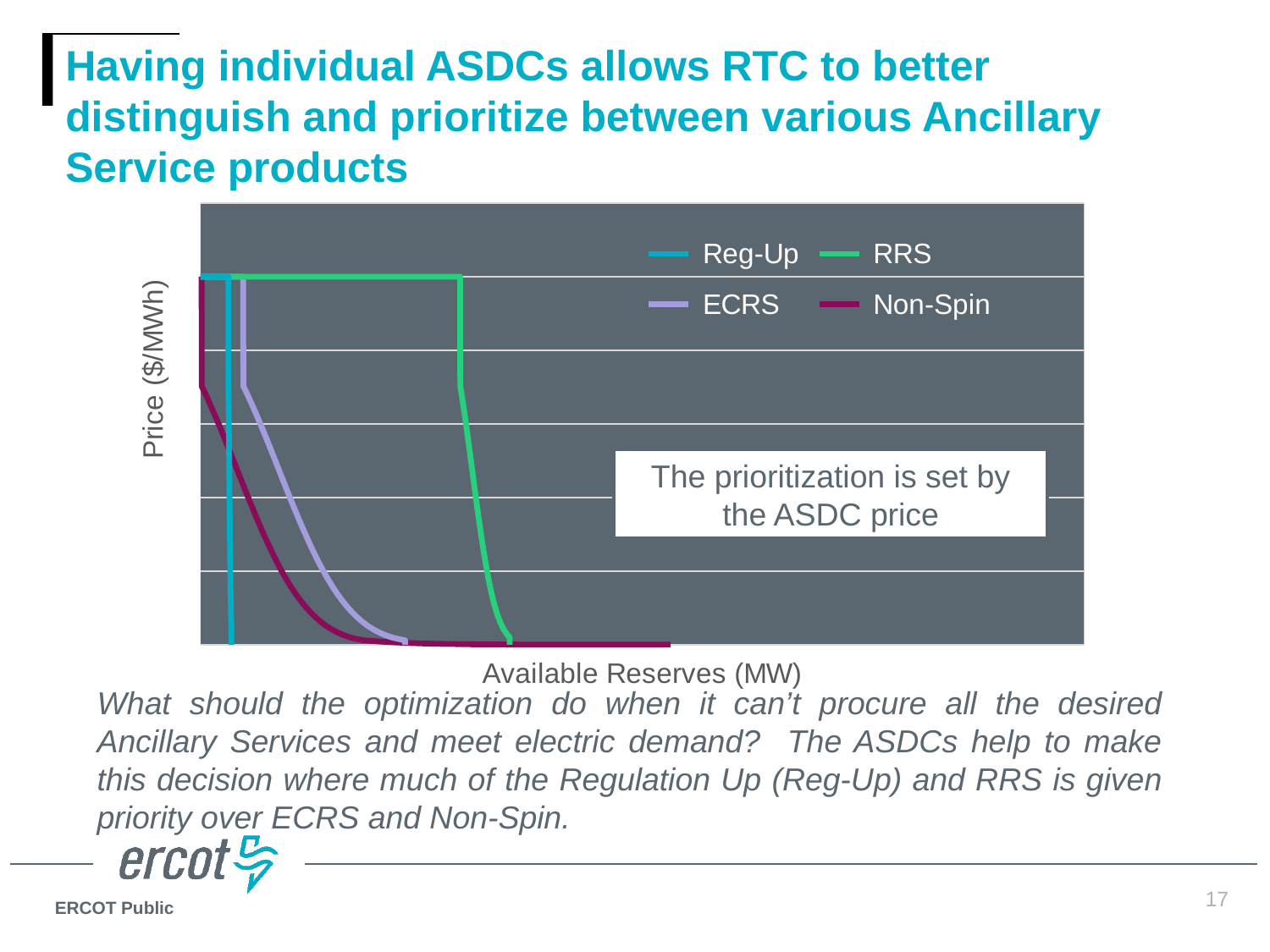
Which series are listed in the chart's legend? Reg-Up, RRS, ECRS, Non-Spin Which series drops to the bottom of the chart at the smallest available reserves value? Reg-Up Which series extends furthest to the right along the Available Reserves axis? Non-Spin How many series does the chart's legend list? 4 What kind of chart is shown on the slide? line chart What is the label of the chart's vertical axis? Price ($/MWh) What does the text box inside the chart say? The prioritization is set by the ASDC price Which series reaches the bottom of the chart at a larger available reserves value, ECRS or RRS? RRS Which series stays at the top price level for a wider range of available reserves, Reg-Up or RRS? RRS What is the label of the chart's horizontal axis? Available Reserves (MW) Do the plotted price curves rise or fall as available reserves increase along the x axis? fall